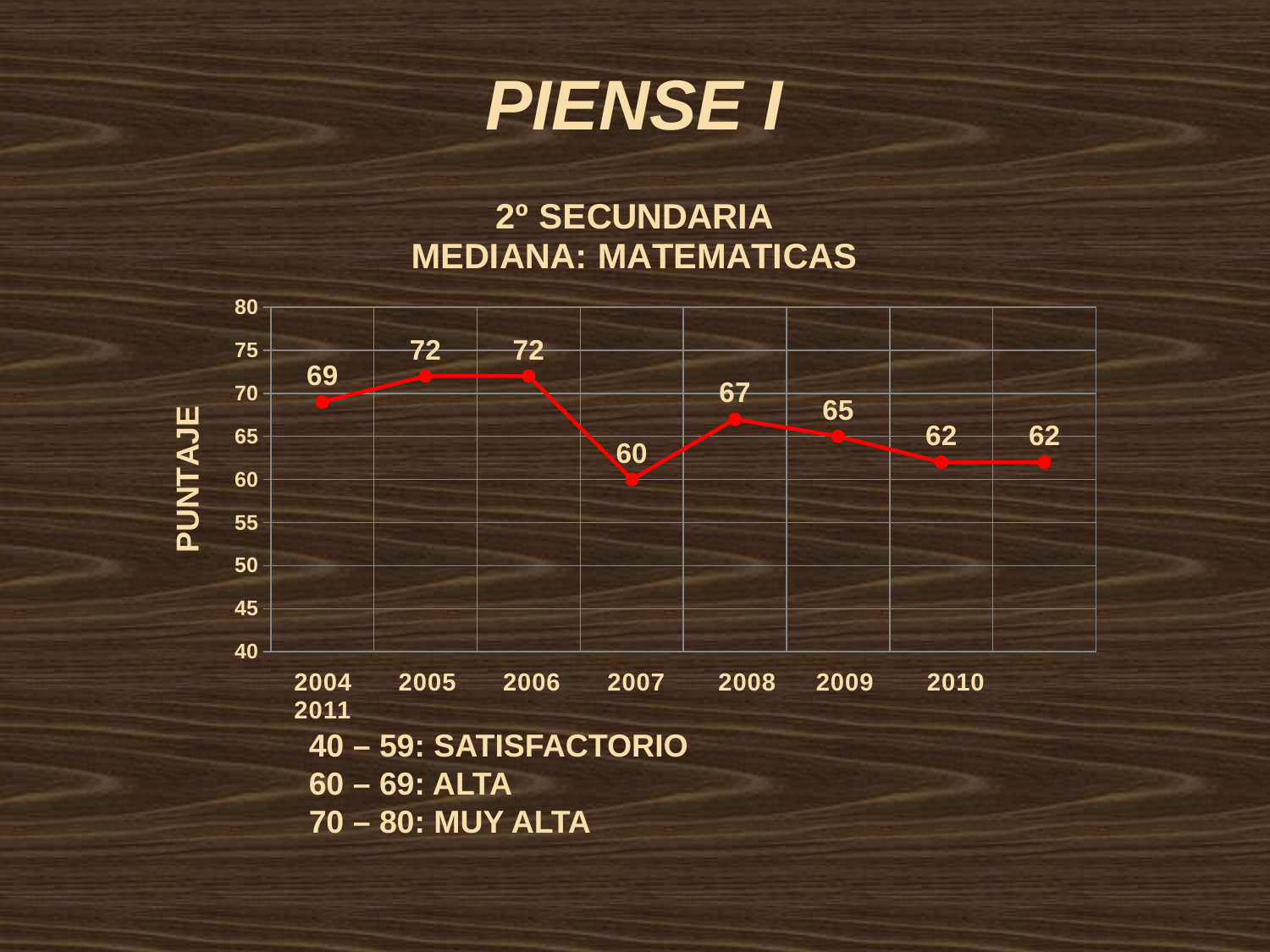
What is the median mathematics score for 2004? 69 What type of chart is shown on the slide? line chart What is the label on the vertical axis of the chart? PUNTAJE What is the value plotted for 2009? 65 What is the value plotted for 2010? 62 Which year has the lowest value on the chart? 2007 What is the difference between the values for 2008 and 2009? 2 What is the difference between the values for 2006 and 2007? 12 How many data points are plotted on the chart? 8 Which is larger, the value for 2004 or the value for 2008? 2004 What is the value plotted for 2007? 60 What is the highest value shown on the chart? 72